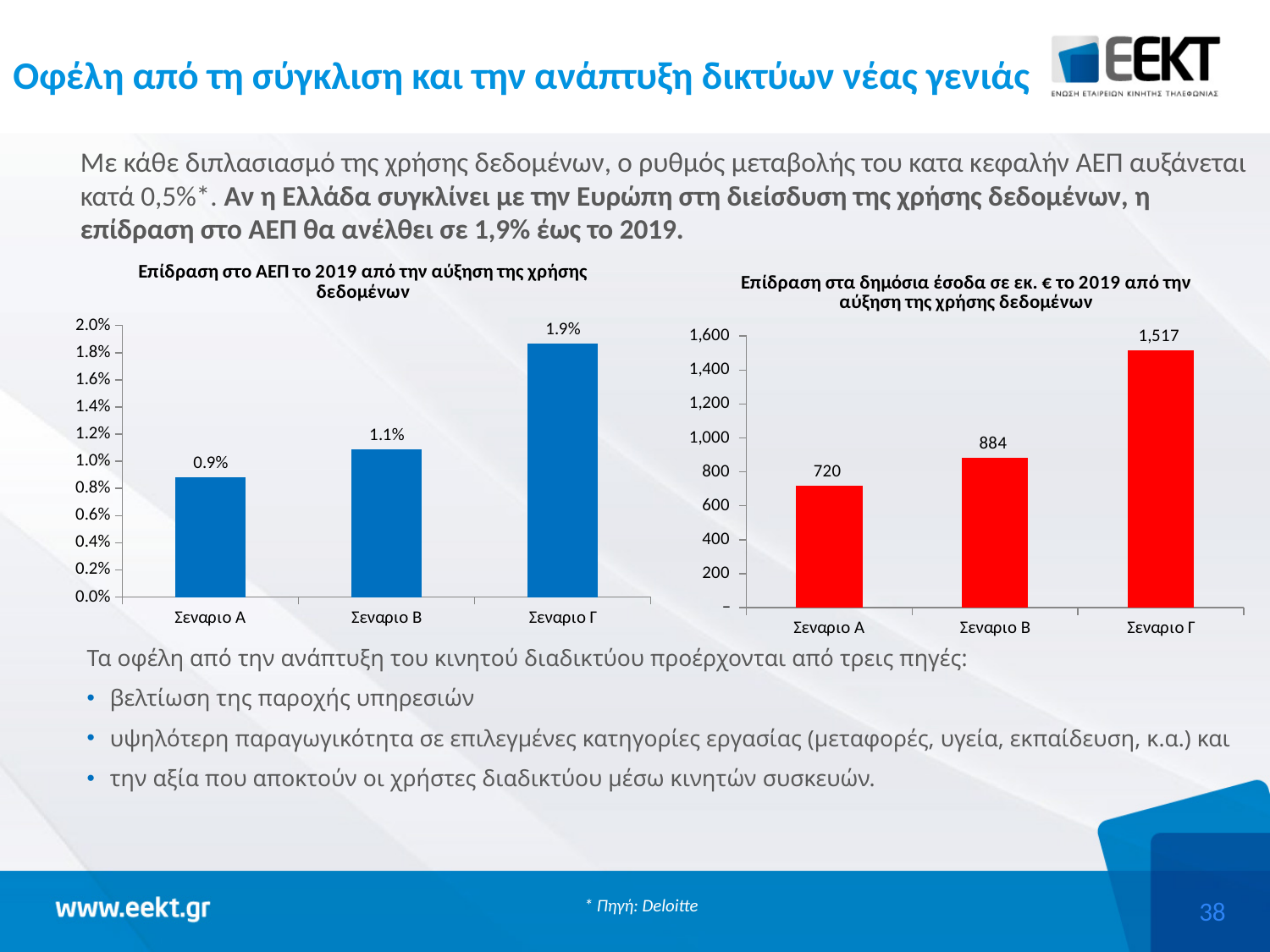
In the left chart (Επίδραση στο ΑΕΠ το 2019), which scenario has the lowest value? Σεναριο Α In the left chart (Επίδραση στο ΑΕΠ το 2019), what is the difference between Σεναριο Γ and Σεναριο Α? 1.0% In the right chart (Επίδραση στα δημόσια έσοδα), what is the difference between Σεναριο Γ and Σεναριο Β? 633 In the left chart (Επίδραση στο ΑΕΠ το 2019), which scenario has the highest value? Σεναριο Γ In the left chart (Επίδραση στο ΑΕΠ το 2019), how many scenarios are shown? 3 In the right chart (Επίδραση στα δημόσια έσοδα), which is larger, Σεναριο Α or Σεναριο Β? Σεναριο Β In the left chart (Επίδραση στο ΑΕΠ το 2019 από την αύξηση της χρήσης δεδομένων), what is the value for Σεναριο Β? 1.1% In the right chart (Επίδραση στα δημόσια έσοδα σε εκ. € το 2019), what is the value for Σεναριο Γ? 1,517 What colour are the bars in the left chart (Επίδραση στο ΑΕΠ το 2019)? blue What type of chart is the right chart (Επίδραση στα δημόσια έσοδα)? bar chart In the right chart (Επίδραση στα δημόσια έσοδα), do the values rise or fall from Σεναριο Α to Σεναριο Γ? rise In the right chart (Επίδραση στα δημόσια έσοδα σε εκ. € το 2019), what is the value for Σεναριο Α? 720